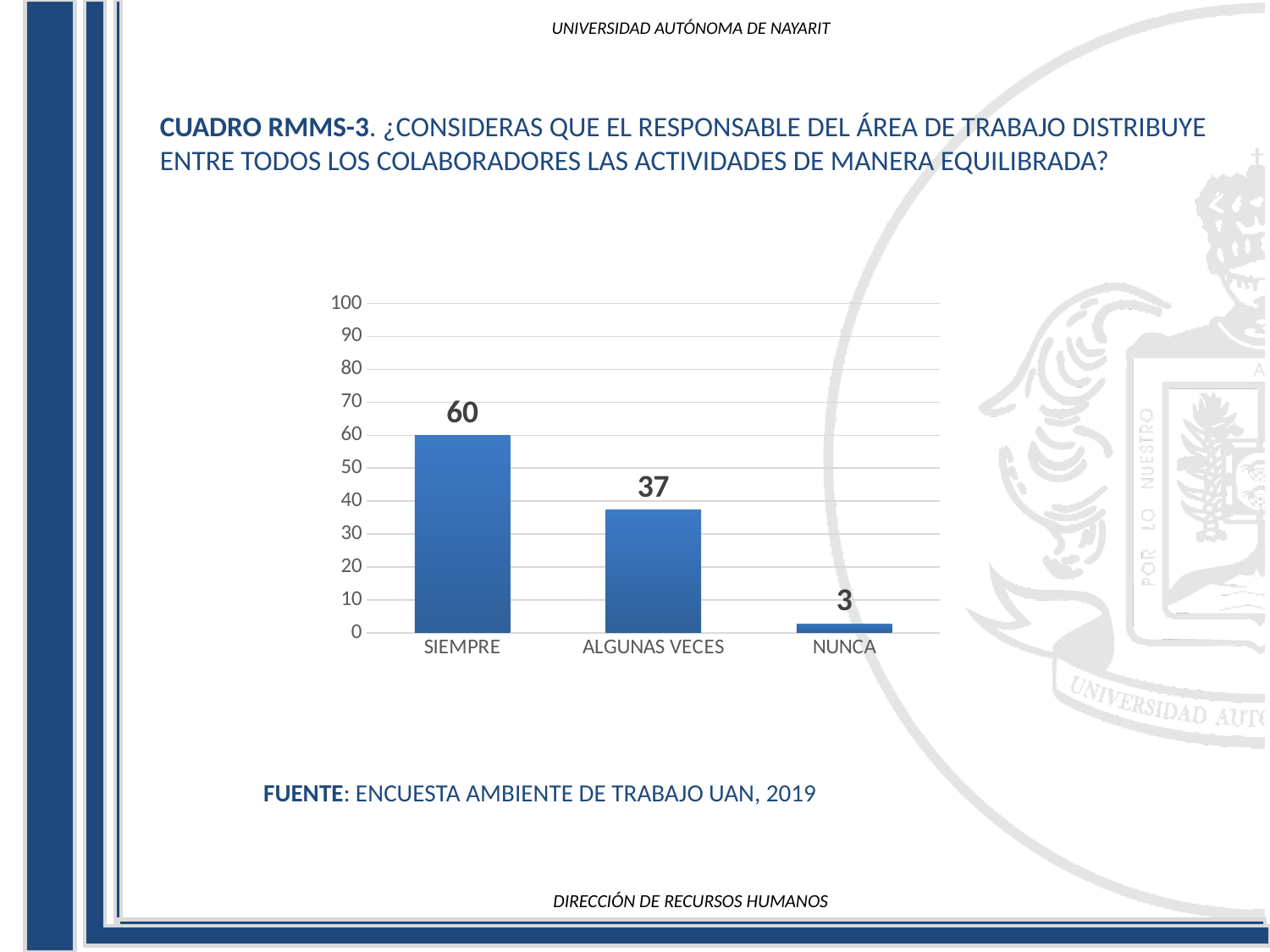
Which category has the highest value? SIEMPRE What kind of chart is shown on the slide? bar chart What is the difference between the values for SIEMPRE and ALGUNAS VECES? 23 What is the difference between the values for ALGUNAS VECES and NUNCA? 34 Do the values rise or fall from left to right along the x axis? fall Is the value for SIEMPRE greater or less than 50? greater Which is larger, the value for ALGUNAS VECES or the value for NUNCA? ALGUNAS VECES Which category has the lowest value? NUNCA What is the value for SIEMPRE? 60 How many categories are shown on the x axis? 3 What is the value for ALGUNAS VECES? 37 What is the value for NUNCA? 3